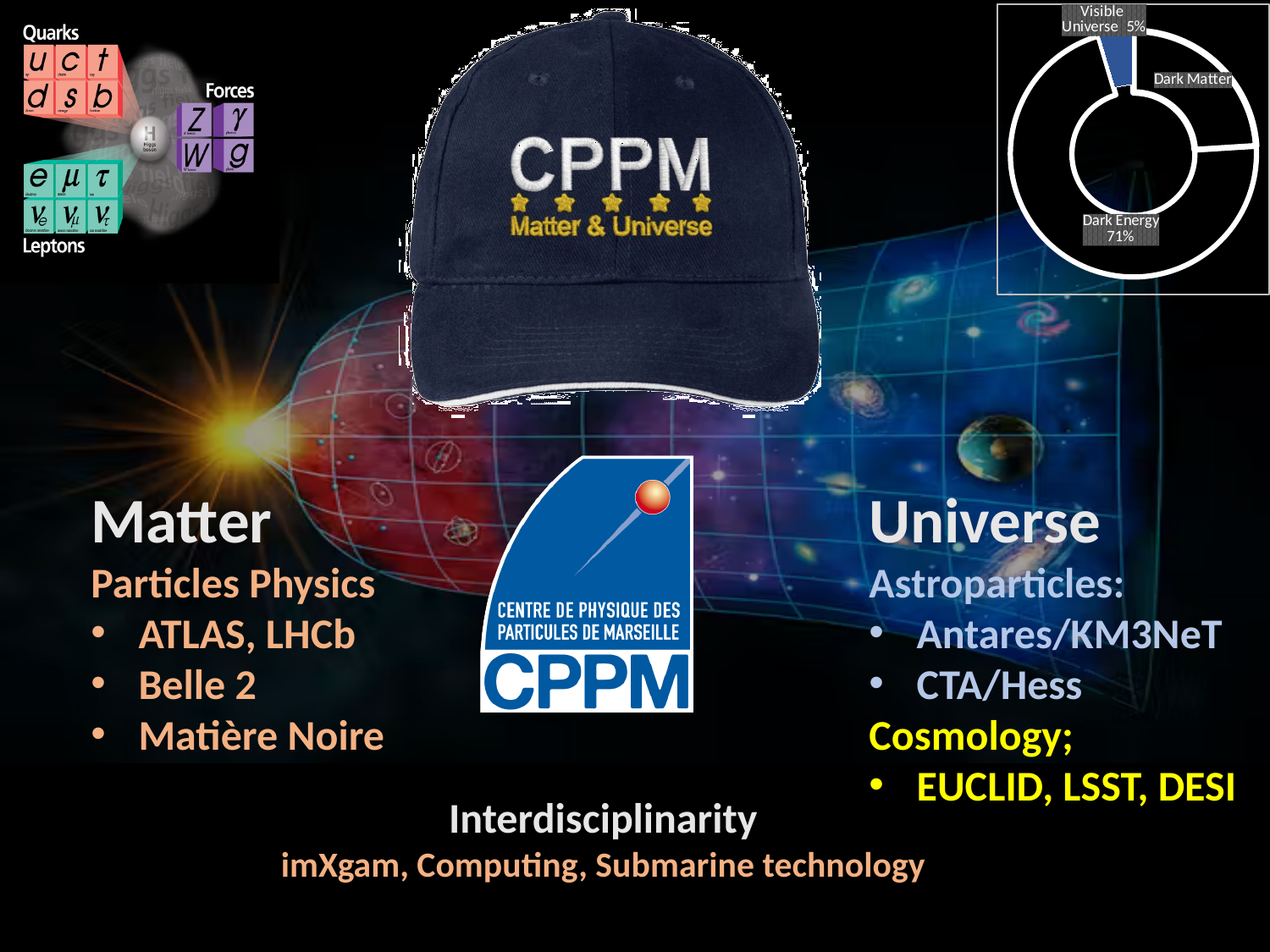
Which is larger in the doughnut chart, Dark Energy or Visible Universe? Dark Energy What are the three categories shown in the doughnut chart? Visible Universe, Dark Matter, Dark Energy By how many percentage points does Dark Energy exceed Visible Universe in the doughnut chart? 66 Which slice of the doughnut chart is the smallest? Visible Universe What share of the doughnut chart is labelled Dark Energy? 71% What kind of chart is shown in the top right corner of the slide? Doughnut (pie) chart Which slice of the doughnut chart is the largest? Dark Energy What share of the doughnut chart is labelled Visible Universe? 5% Which is larger in the doughnut chart, Dark Matter or Visible Universe? Dark Matter How many slices does the doughnut chart have? 3